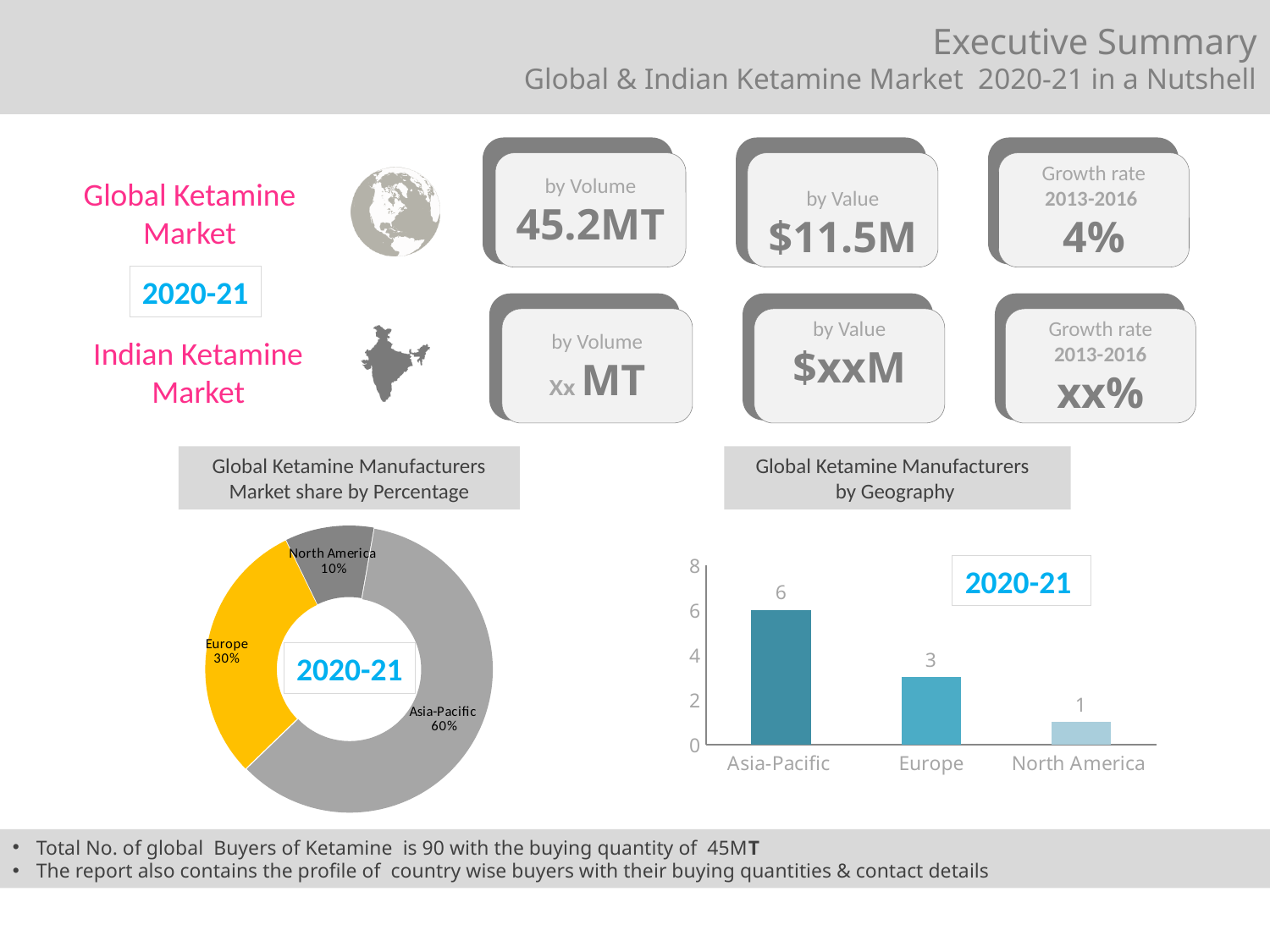
What kind of chart is the 'Global Ketamine Manufacturers Market share by Percentage' chart? Doughnut chart In the 'Global Ketamine Manufacturers by Geography' chart, do the values rise or fall from Asia-Pacific to North America? Fall In the 'Global Ketamine Manufacturers by Geography' chart, what is the value for North America? 1 In the 'Global Ketamine Manufacturers by Geography' chart, what is the difference between Asia-Pacific and Europe? 3 In the 'Global Ketamine Manufacturers Market share by Percentage' chart, what share does Europe hold? 30% In the 'Global Ketamine Manufacturers Market share by Percentage' chart, which region has the smallest share? North America In the 'Global Ketamine Manufacturers Market share by Percentage' chart, what share does Asia-Pacific hold? 60% What kind of chart is the 'Global Ketamine Manufacturers by Geography' chart? Bar chart In the 'Global Ketamine Manufacturers by Geography' chart, what is the value for Asia-Pacific? 6 In the 'Global Ketamine Manufacturers Market share by Percentage' chart, how many regions are shown? 3 In the 'Global Ketamine Manufacturers Market share by Percentage' chart, what is the difference between the Asia-Pacific and Europe shares? 30% In the 'Global Ketamine Manufacturers by Geography' chart, which region has the highest value? Asia-Pacific